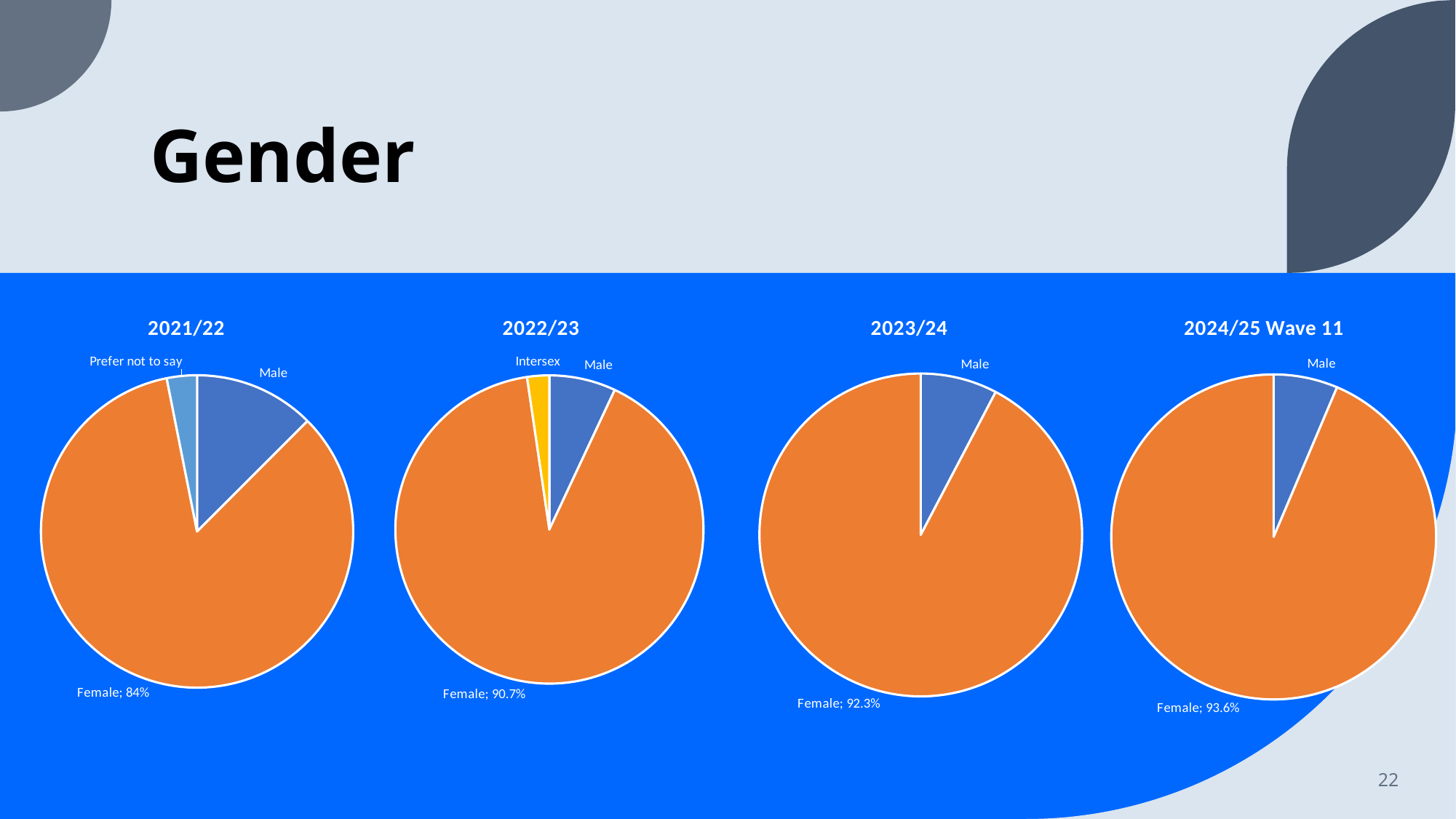
Is the Female share larger in the 2022/23 pie chart or the 2023/24 pie chart? 2023/24 What kind of chart is used on this slide? Pie chart In the 2024/25 Wave 11 pie chart, what percentage is labelled for Female? 93.6% Across the four pie charts, which year has the lowest Female percentage? 2021/22 What is the difference in percentage points between the Female share in 2024/25 Wave 11 and in 2021/22? 9.6 percentage points In the 2022/23 pie chart, what percentage is labelled for Female? 90.7% How many slices does the 2022/23 pie chart have? 3 In the 2023/24 pie chart, what percentage is labelled for Female? 92.3% Does the Female percentage rise or fall from 2021/22 to 2024/25 Wave 11? Rise How many slices does the 2024/25 Wave 11 pie chart have? 2 In the 2021/22 pie chart, what percentage is labelled for Female? 84% Across the four pie charts, which year has the highest Female percentage? 2024/25 Wave 11